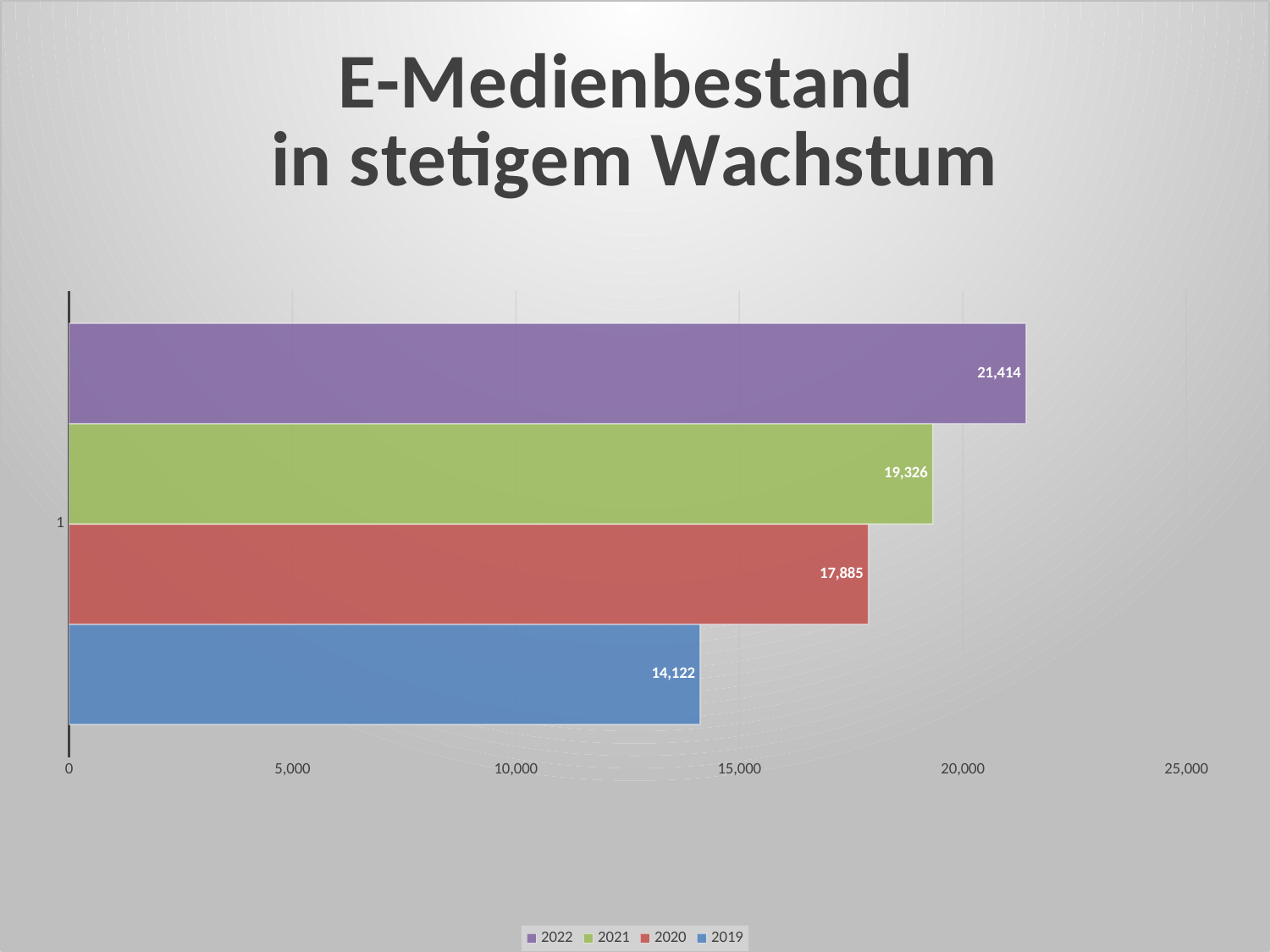
What is the value for 2019? 14,122 What is the value for 2020? 17,885 Which year has the highest value? 2022 What is the difference between the values for 2021 and 2020? 1,441 What is the title of the slide? E-Medienbestand in stetigem Wachstum What is the value for 2021? 19,326 What kind of chart is shown on the slide? bar chart What is the difference between the values for 2022 and 2019? 7,292 What is the value for 2022? 21,414 How many series does the legend list? 4 Which is larger, the value for 2020 or the value for 2021? 2021 Which year has the lowest value? 2019